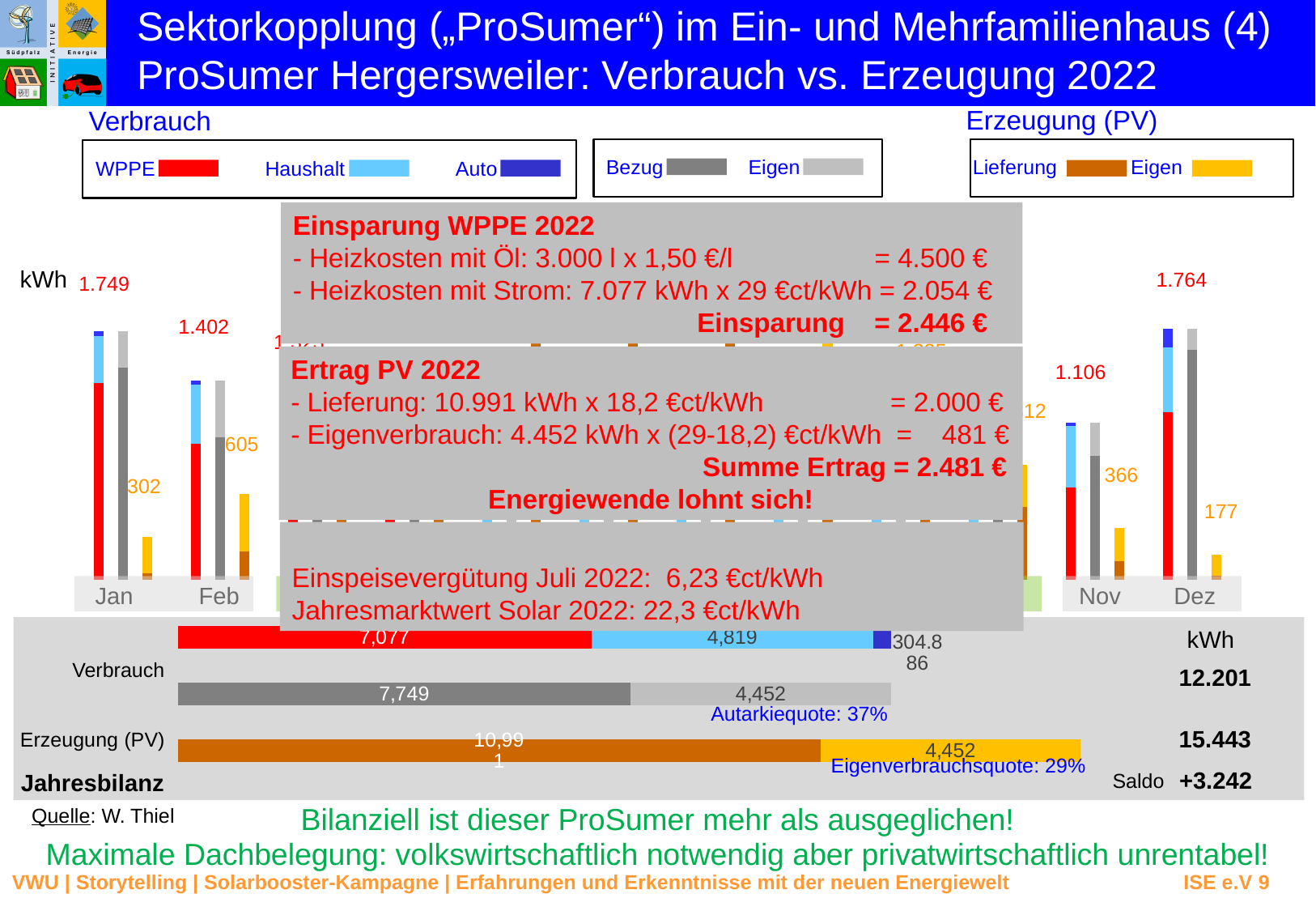
In the monthly chart, among the visible months Jan, Feb, Nov and Dez, which has the lowest orange PV value? Dez In the monthly chart, what is the orange PV value labelled for Feb? 605 In the Jahresbilanz bars at the bottom, what is the total kWh shown for Erzeugung (PV)? 15.443 In the monthly chart, which has the larger red consumption value, Feb or Nov? Feb In the monthly chart, what is the red consumption value labelled above the Jan bars? 1.749 In the monthly chart, what is the red consumption value labelled above the Dez bars? 1.764 In the monthly chart, among the visible months Jan, Feb, Nov and Dez, which has the highest orange PV value? Feb In the monthly chart, what is the orange PV value labelled for Dez? 177 In the Jahresbilanz bars at the bottom, what is the total kWh shown for Verbrauch? 12.201 How many series does the Verbrauch legend list? 3 In the monthly chart, what is the difference between the red consumption values for Dez (1.764) and Jan (1.749)? 15 In the Jahresbilanz bars at the bottom, what value is labelled on the grey Bezug segment of the Verbrauch bar? 7,749